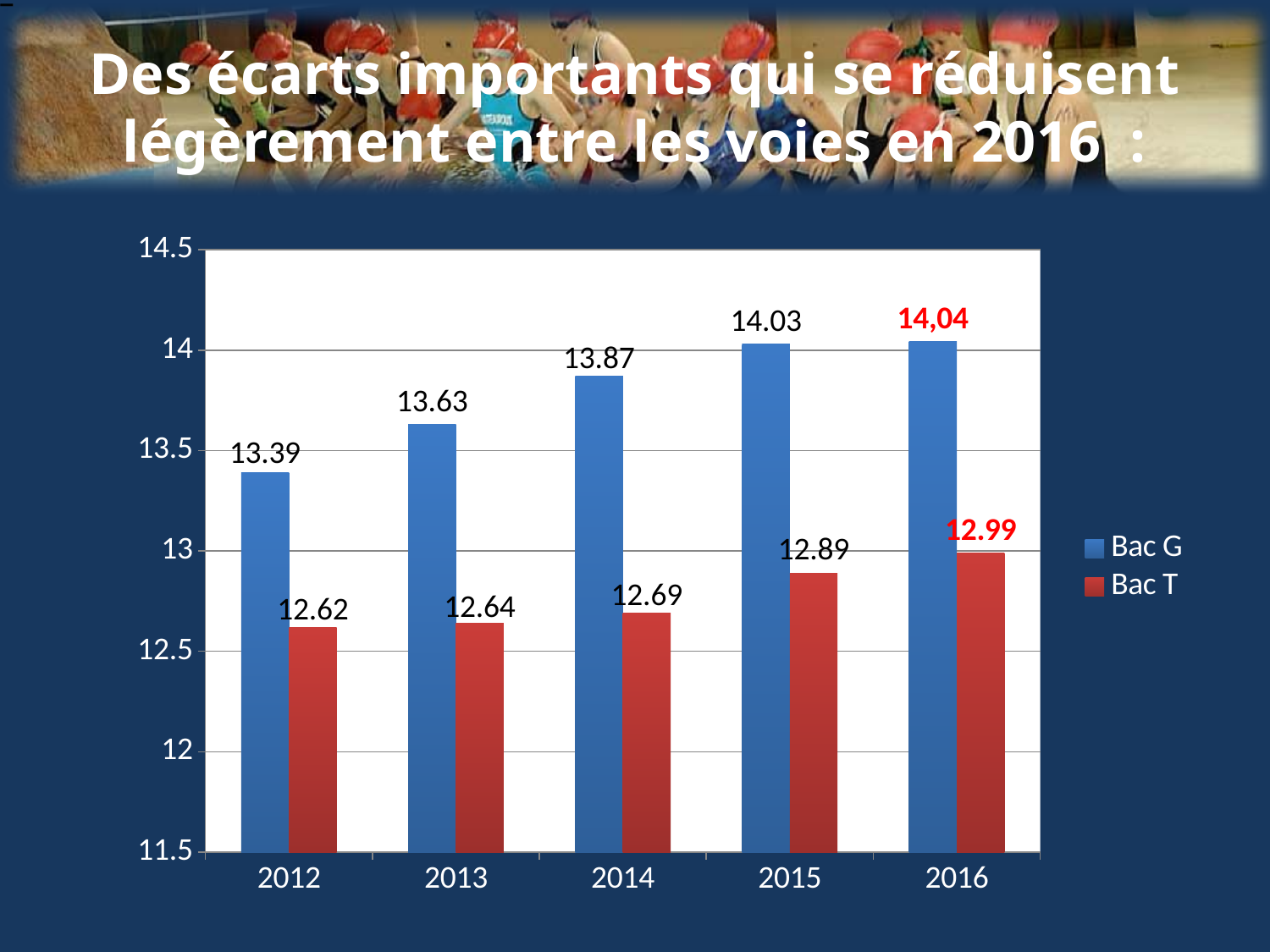
Do the Bac T values rise or fall from 2012 to 2016? Rise What is the value for Bac G in 2012? 13.39 What kind of chart is shown on the slide? Bar chart Which is larger in 2015, Bac G or Bac T? Bac G How many years are shown on the x axis? 5 What is the value for Bac G in 2016? 14,04 In which year is the Bac G value lowest? 2012 What is the value for Bac T in 2015? 12.89 How many series does the legend list? 2 What is the value for Bac T in 2014? 12.69 What is the difference between Bac G and Bac T in 2013? 0.99 In which year is the Bac T value lowest? 2012